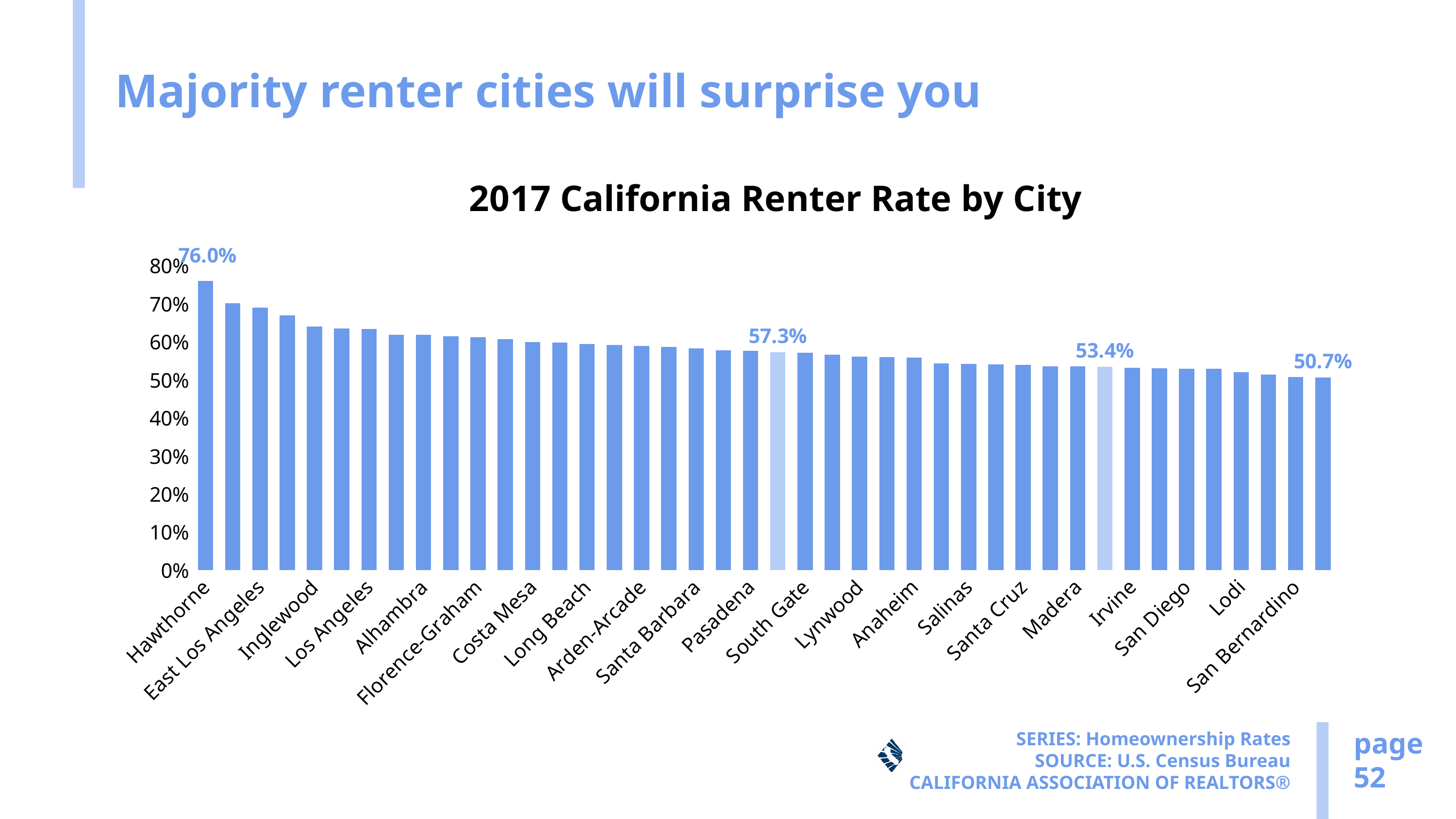
What value is labelled on the first lighter-coloured highlighted bar? 57.3% Do the renter rates rise or fall moving from left to right across the chart? Fall Which city has the highest renter rate in the chart? Hawthorne Which has a higher renter rate, Inglewood or Lodi? Inglewood What type of chart is shown on the slide? Bar chart What value is labelled on the last bar at the right end of the chart? 50.7% Is the value for Los Angeles greater or less than 70%? less What is the renter rate for Hawthorne? 76.0% Is the value for Inglewood greater or less than 60%? greater What value is labelled on the second lighter-coloured highlighted bar? 53.4% What is the difference between the highest labelled value (76.0%) and the lowest labelled value (50.7%)? 25.3 percentage points What is the title of the chart? 2017 California Renter Rate by City